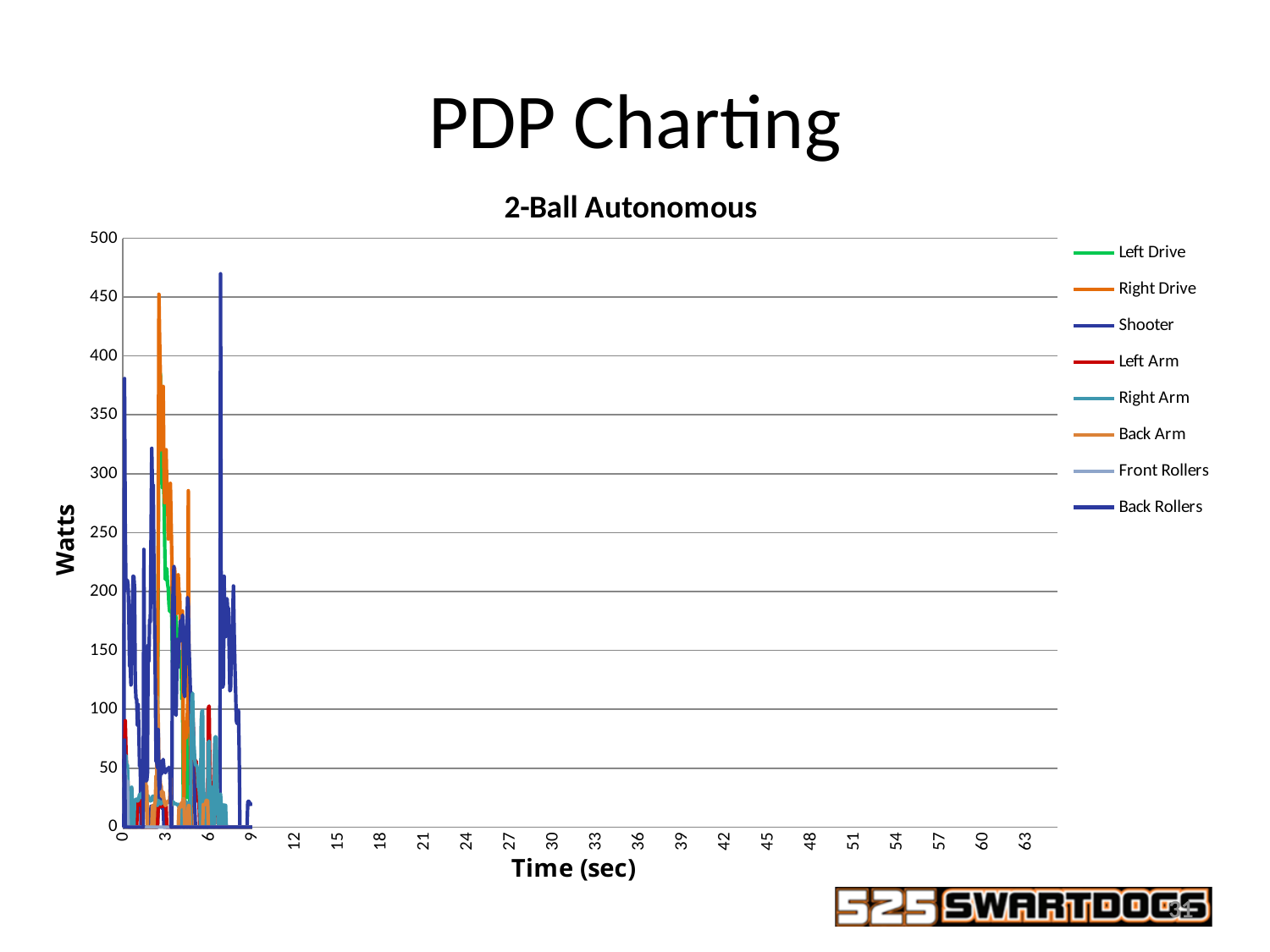
Which series is listed first in the legend? Left Drive How many series does the legend list? 8 How many tick labels are shown on the Time (sec) axis? 22 What kind of chart is shown on the slide? line chart What is the last tick label on the Time (sec) axis? 63 Is the highest peak reached by any line on the chart greater or less than 450 watts? greater What is the title of the chart? 2-Ball Autonomous Is the highest peak reached by any line on the chart greater or less than 500 watts? less What is the maximum value shown on the Watts axis? 500